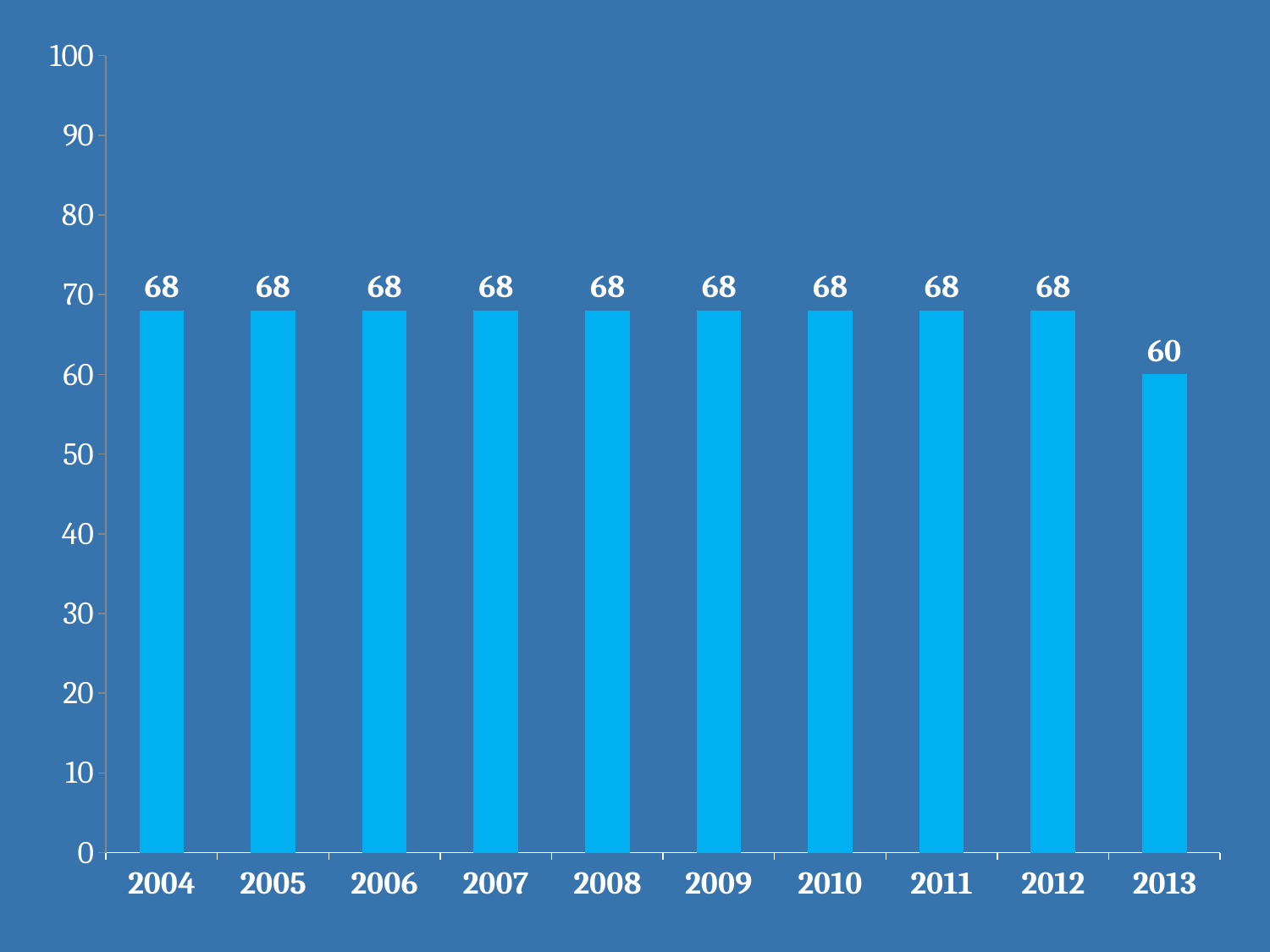
Is the value for 2013 greater or less than 70? less How many years are shown on the x axis? 10 What kind of chart is shown on the slide? bar chart Which is larger, the value for 2004 or the value for 2013? 2004 What is the difference between the values for 2012 and 2013? 8 What is the value for 2008? 68 Does the value rise, fall or stay the same from 2004 to 2012? stays the same How many years have a value of 68? 9 Which year has the lowest value? 2013 What is the maximum value shown on the y axis? 100 What is the value for 2013? 60 Is the value for 2010 greater or less than 60? greater